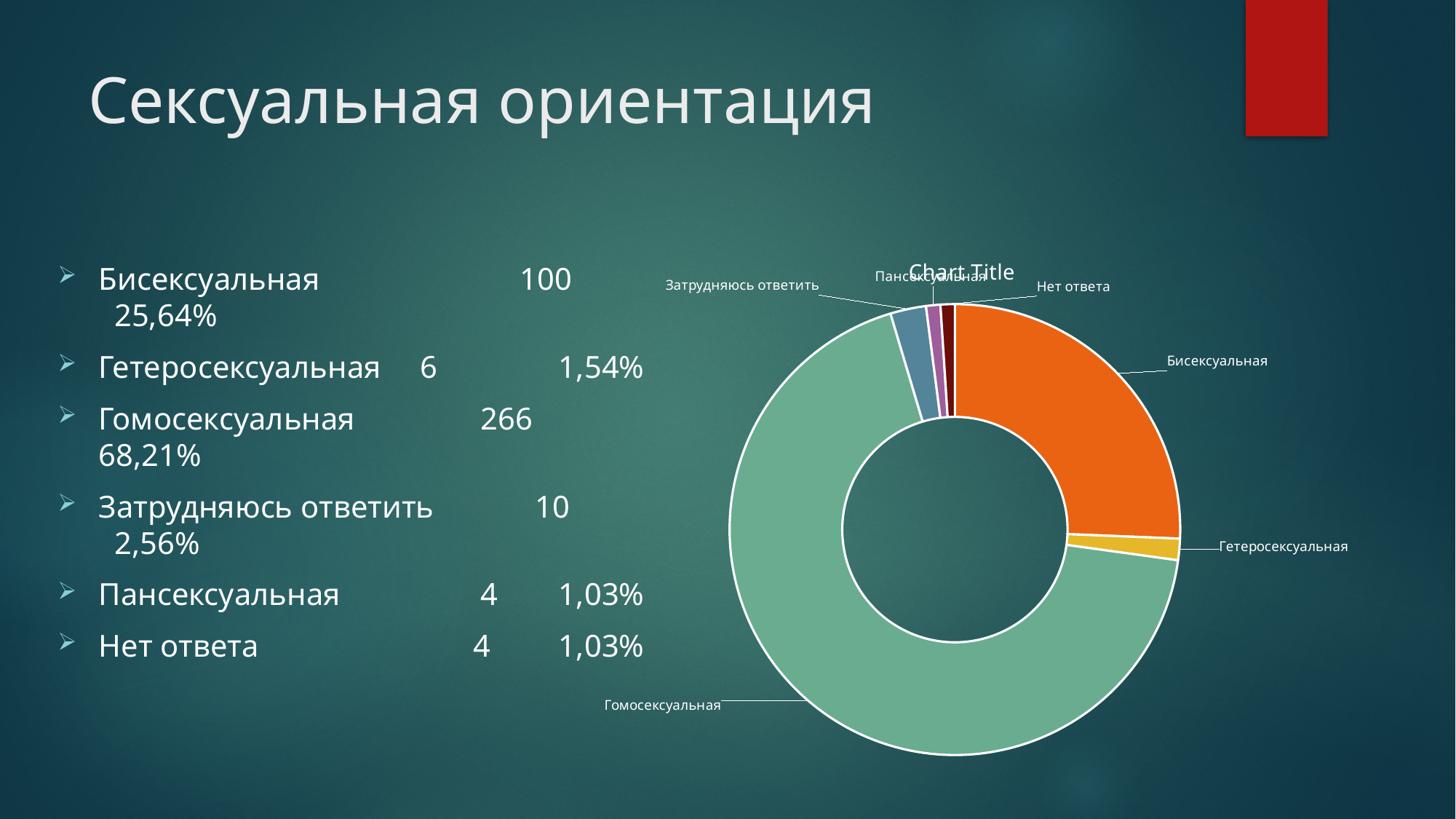
What is the count for Затрудняюсь ответить shown on the slide? 10 Which category has the largest slice in the doughnut chart? Гомосексуальная What share of the doughnut chart does Гомосексуальная take, according to the slide? 68,21% What is the difference between the counts for Гомосексуальная and Бисексуальная? 166 What is the count for Гетеросексуальная shown on the slide? 6 What colour is the Бисексуальная slice in the doughnut chart? Orange What share of the doughnut chart does Бисексуальная take, according to the slide? 25,64% What is the title shown above the doughnut chart? Chart Title How many categories does the doughnut chart show? 6 Which slice is larger, Бисексуальная or Гетеросексуальная? Бисексуальная Which slice is larger, Затрудняюсь ответить or Гетеросексуальная? Затрудняюсь ответить What kind of chart is shown on the slide? Doughnut chart